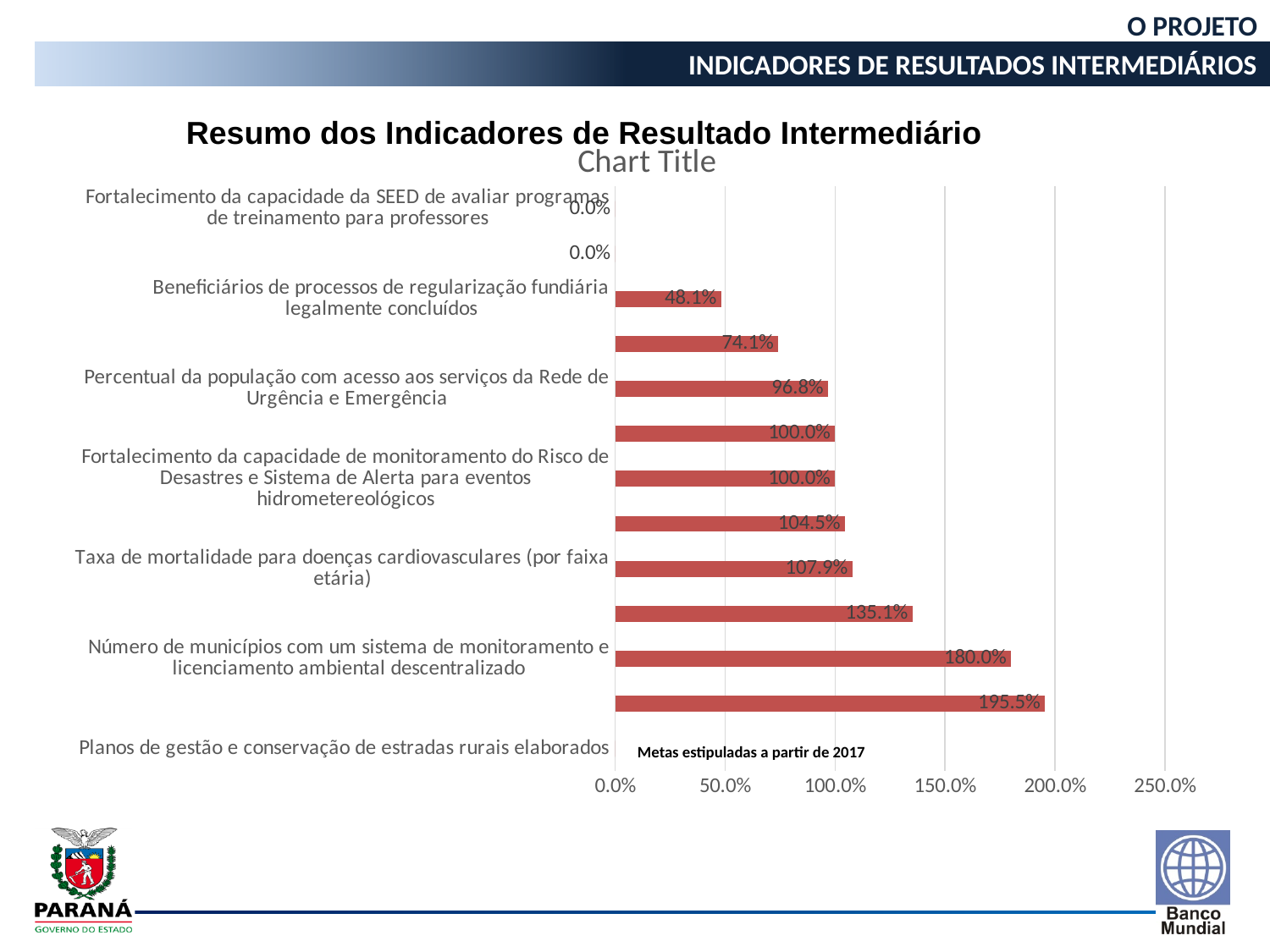
What is the title printed directly above the chart's plot area? Chart Title Which is larger: the value for 'Beneficiários de processos de regularização fundiária legalmente concluídos' or for 'Percentual da população com acesso aos serviços da Rede de Urgência e Emergência'? Percentual da população com acesso aos serviços da Rede de Urgência e Emergência What is the value for 'Percentual da população com acesso aos serviços da Rede de Urgência e Emergência'? 96.8% How many bars show a value of exactly 100.0%? 2 What is the difference between the values for 'Número de municípios com um sistema de monitoramento e licenciamento ambiental descentralizado' and 'Taxa de mortalidade para doenças cardiovasculares (por faixa etária)'? 72.1% What is the value for 'Taxa de mortalidade para doenças cardiovasculares (por faixa etária)'? 107.9% What is the value for 'Número de municípios com um sistema de monitoramento e licenciamento ambiental descentralizado'? 180.0% What is the value for 'Beneficiários de processos de regularização fundiária legalmente concluídos'? 48.1% What type of chart is shown on the slide? bar chart Is the value for 'Beneficiários de processos de regularização fundiária legalmente concluídos' greater or less than 50.0%? less What is the largest value labeled on the chart? 195.5% What is the value for 'Fortalecimento da capacidade da SEED de avaliar programas de treinamento para professores'? 0.0%